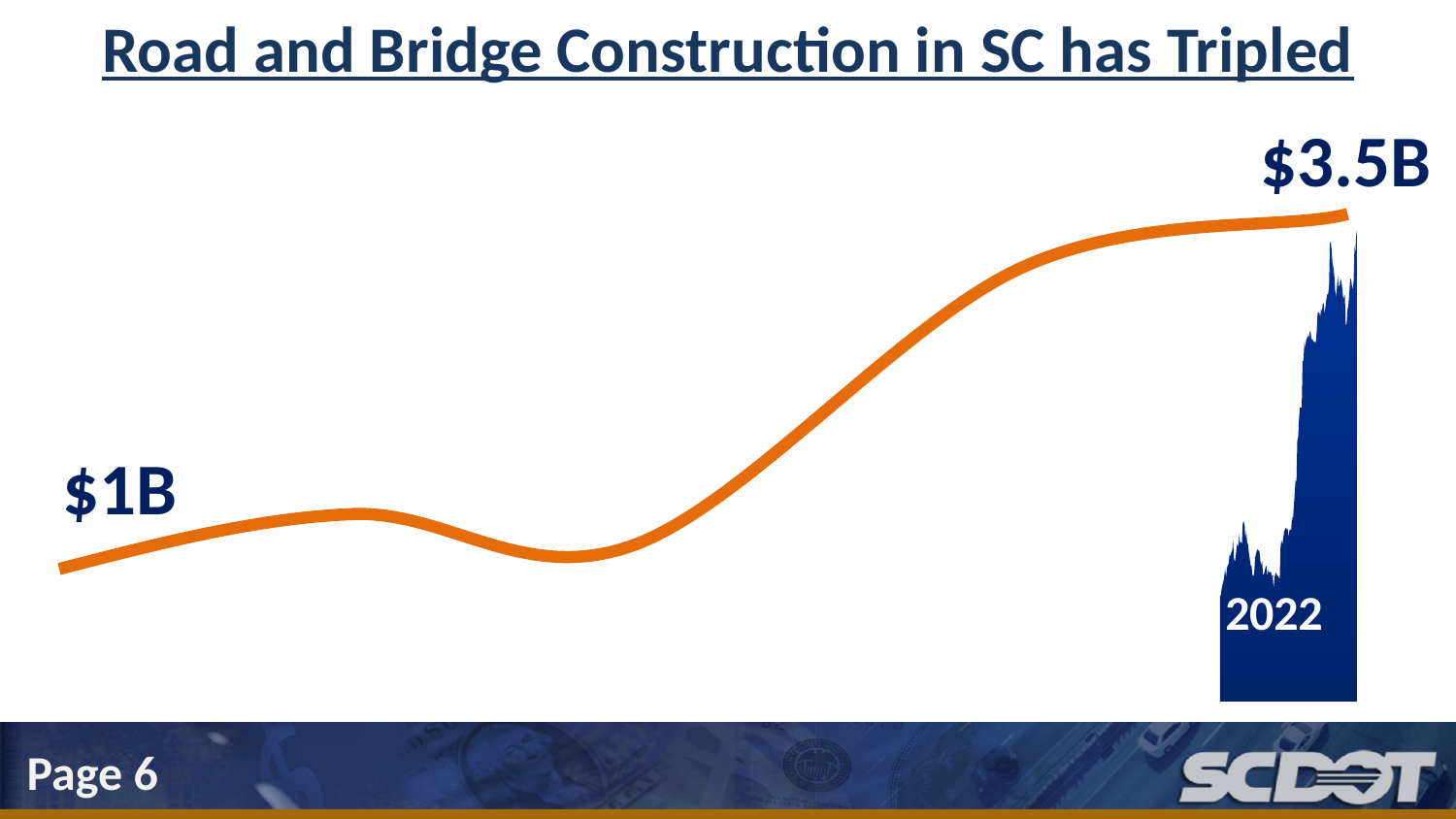
What is the highest value labeled on the chart? $3.5B What value is labeled at the start of the line on the chart? $1B What colour is the line on the chart? orange Which year is labeled at the right end of the chart? 2022 What is the difference between the 2022 value and the starting value shown on the chart? $2.5B What kind of chart is shown on the slide? area chart Which is larger, the starting value or the 2022 value? 2022 value ($3.5B) How many values are labeled on the chart? 2 What is the title of the chart on the slide? Road and Bridge Construction in SC has Tripled Do the values on the chart rise or fall from left to right overall? rise What is the lowest value labeled on the chart? $1B What value is labeled at the end of the line, for 2022? $3.5B